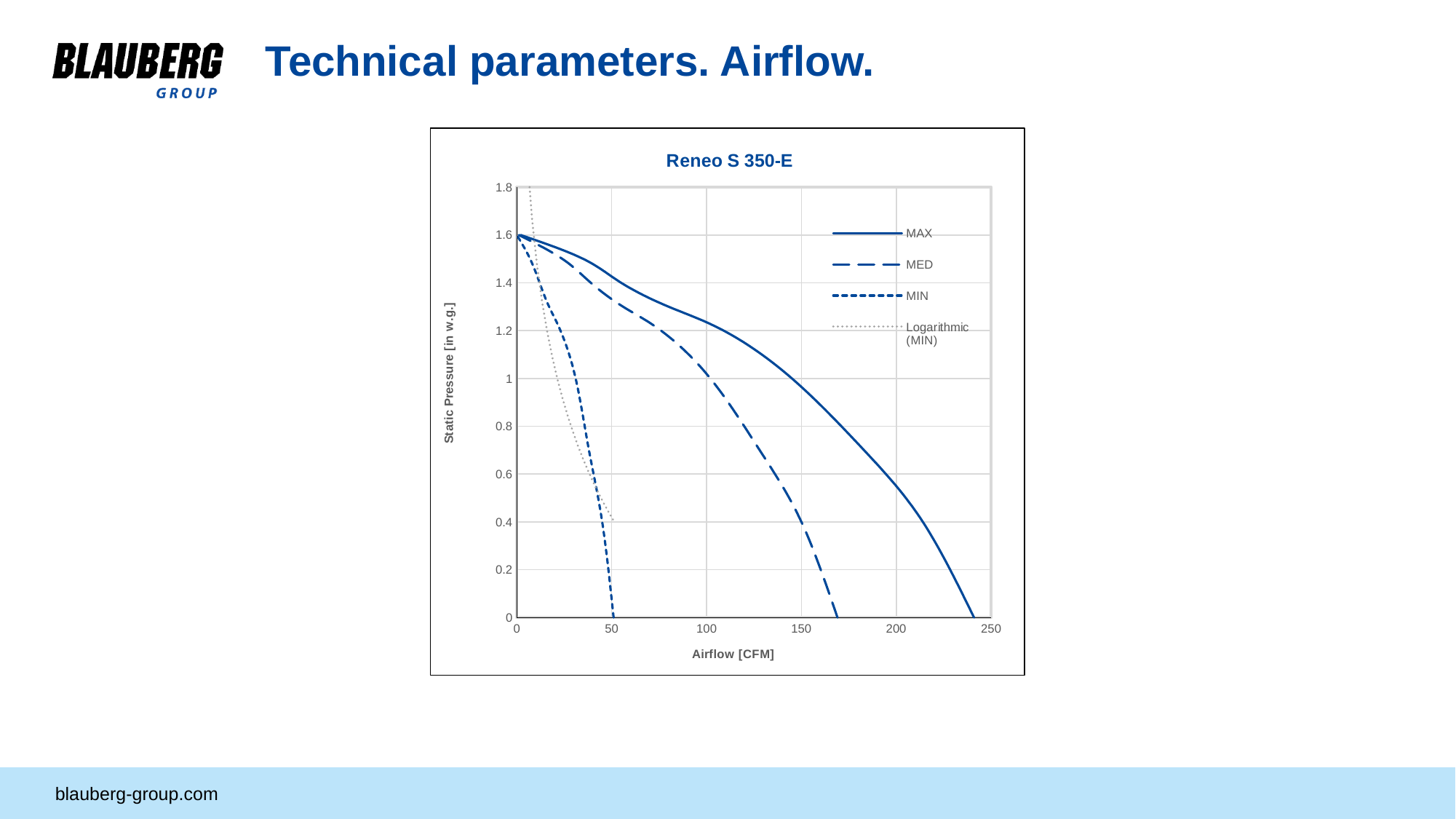
What kind of chart is shown on the slide? line chart Which series reaches 0 static pressure at the lowest airflow? MIN How many series does the chart legend list? 4 Is the static pressure of the MIN series at 50 CFM greater or less than 0.2? less Is the static pressure of the MED series at 50 CFM greater or less than 1.2? greater Do the MAX, MED and MIN curves rise or fall as airflow increases? fall Is the static pressure of the MAX series at 100 CFM greater or less than 1? greater What is the label of the x axis? Airflow [CFM] What is the title of the chart? Reneo S 350-E Which series reaches the highest airflow before its static pressure drops to 0? MAX At 100 CFM, which series has the higher static pressure, MAX or MED? MAX